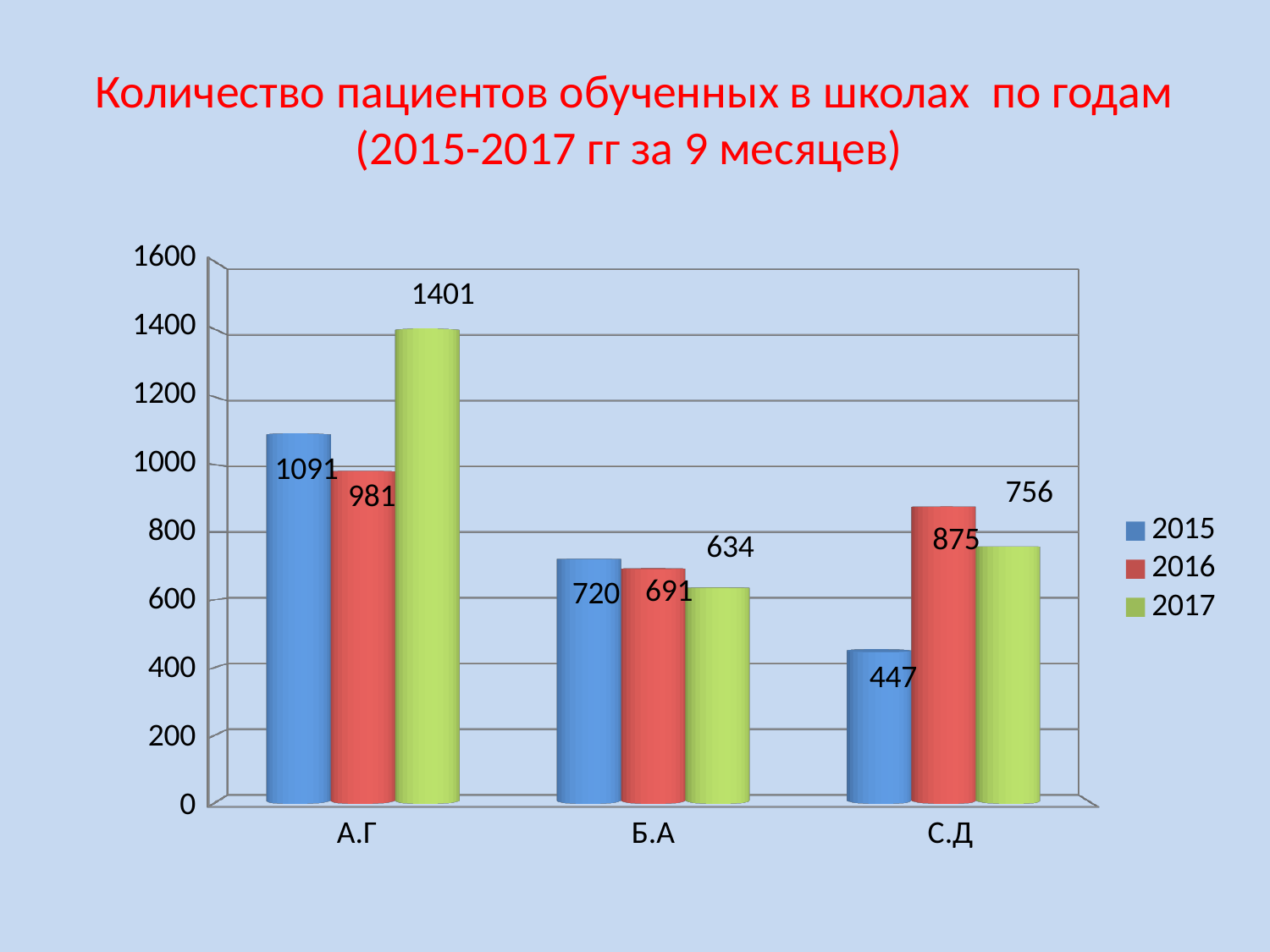
What is the difference between the 2017 and 2015 values for А.Г? 310 What kind of chart is shown on the slide? bar chart How many series does the legend list? 3 Which category has the lowest value in the 2015 series? С.Д What is the value for Б.А in 2016? 691 Which category has the highest value in the 2017 series? А.Г How many categories are shown on the x axis? 3 What is the value for С.Д in 2015? 447 What is the value for А.Г in 2017? 1401 Is the value for Б.А in 2015 greater or less than 600? greater What colour represents the 2016 series in the legend? red Which is larger for С.Д: the 2016 value or the 2017 value? 2016